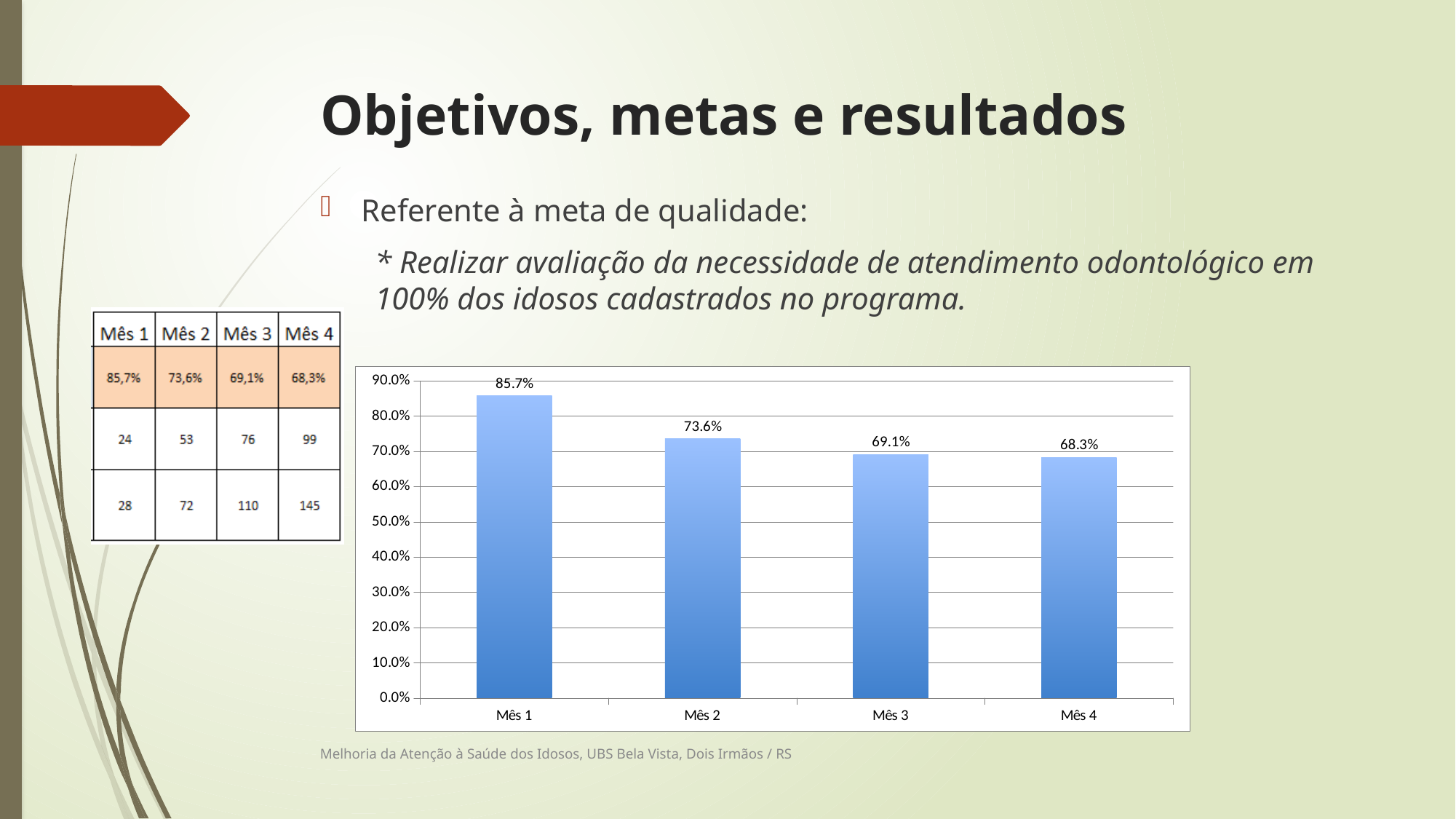
What is the value for Mês 3 in the bar chart? 69.1% What is the difference between the values for Mês 1 and Mês 2? 12.1% What is the difference between the values for Mês 3 and Mês 4? 0.8% Which is larger, the value for Mês 2 or the value for Mês 3? Mês 2 What kind of chart is shown on the slide? Bar chart What is the value for Mês 4 in the bar chart? 68.3% How many months are shown on the x axis of the bar chart? 4 What is the value for Mês 2 in the bar chart? 73.6% Do the values rise or fall from Mês 1 to Mês 4? Fall What is the value for Mês 1 in the bar chart? 85.7% Which month has the lowest value in the bar chart? Mês 4 Which month has the highest value in the bar chart? Mês 1